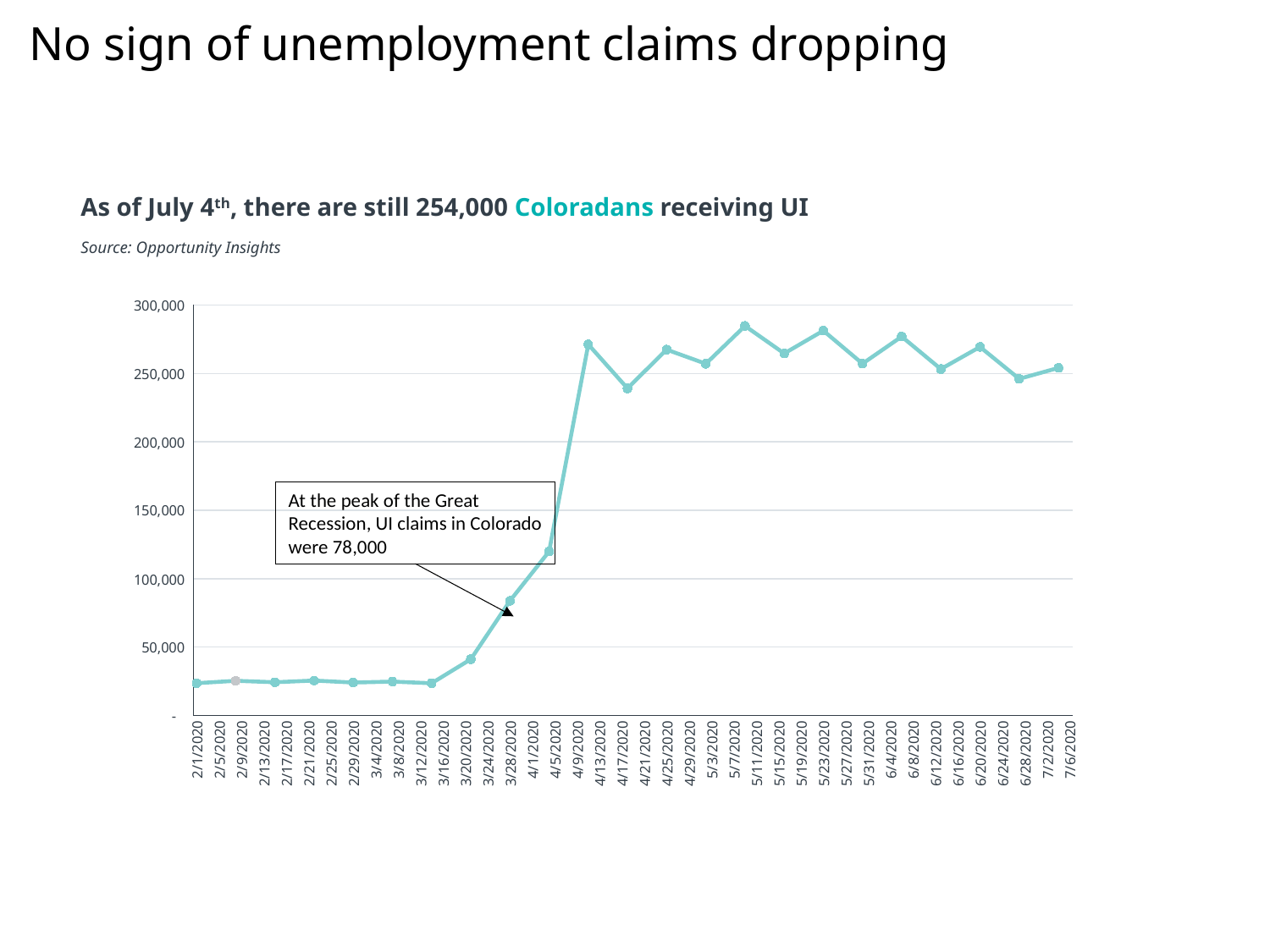
According to the annotation on the chart, what were UI claims in Colorado at the peak of the Great Recession? 78,000 What kind of chart is shown on the slide? line chart Which is larger, the value for 2/1/2020 or the value for 7/6/2020? 7/6/2020 Is the value for 2/1/2020 greater or less than 100,000? less In which month does the line reach its highest point? May Between 3/12/2020 and 4/9/2020, do the values rise or fall? rise Is the value for 2/1/2020 greater or less than 50,000? less Overall, do the values rise or fall from 2/1/2020 to 7/6/2020? rise What is the highest value shown on the y axis? 300,000 Is the value for 7/6/2020 greater or less than 200,000? greater